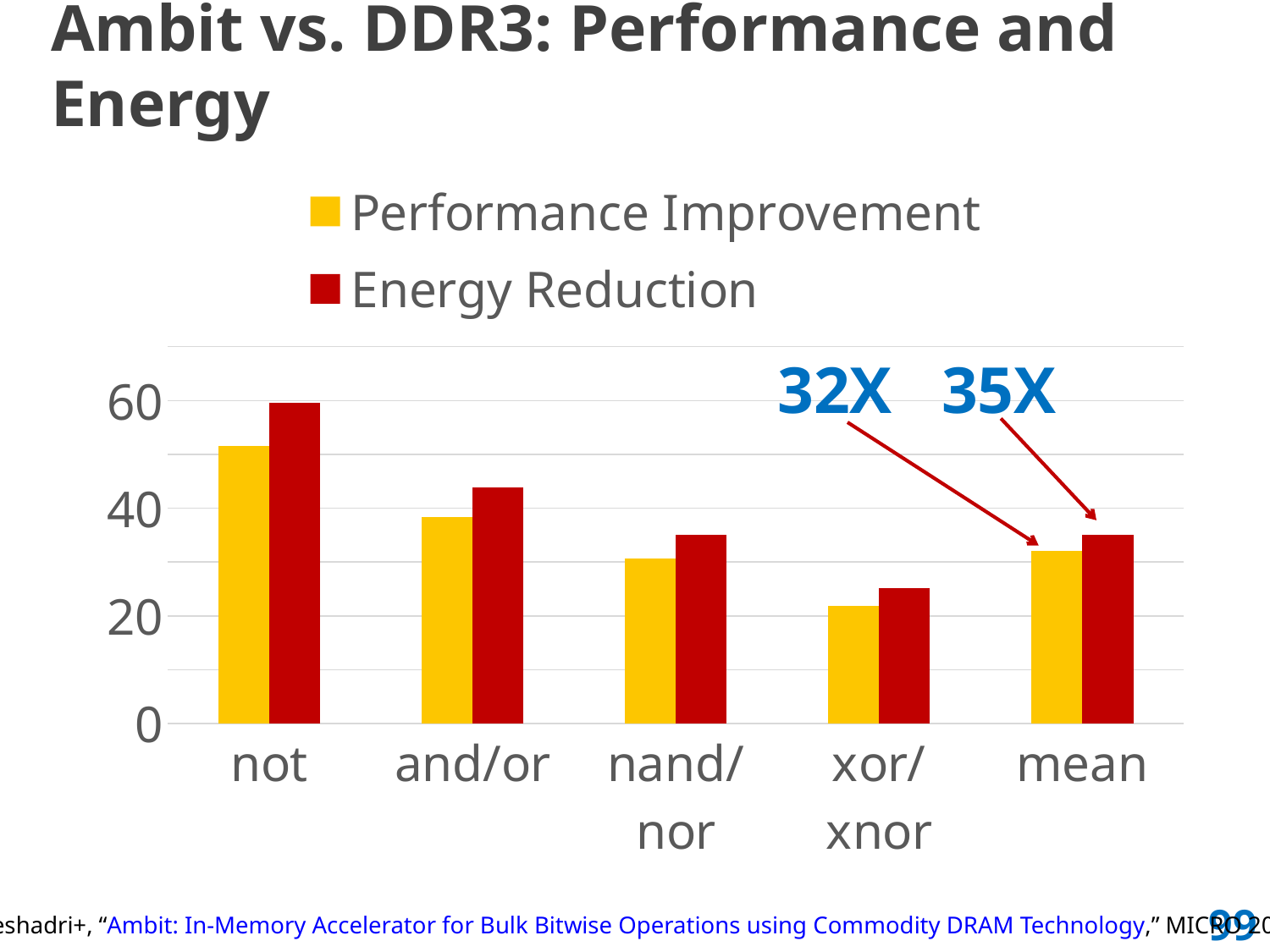
Which operation category has the lowest Energy Reduction? xor/xnor How many categories are shown on the x axis? 5 Which colour represents Energy Reduction in the legend? red For the not category, which is larger: Performance Improvement or Energy Reduction? Energy Reduction Which operation category has the highest Performance Improvement? not What is the annotated Energy Reduction value for the mean category? 35X What is the annotated Performance Improvement value for the mean category? 32X Is the Performance Improvement value for not greater or less than 40? greater How many series does the legend list? 2 Is the Energy Reduction value for xor/xnor greater or less than 40? less What is the difference between the annotated Energy Reduction and Performance Improvement values for the mean category? 3X What kind of chart is shown on the slide? bar chart